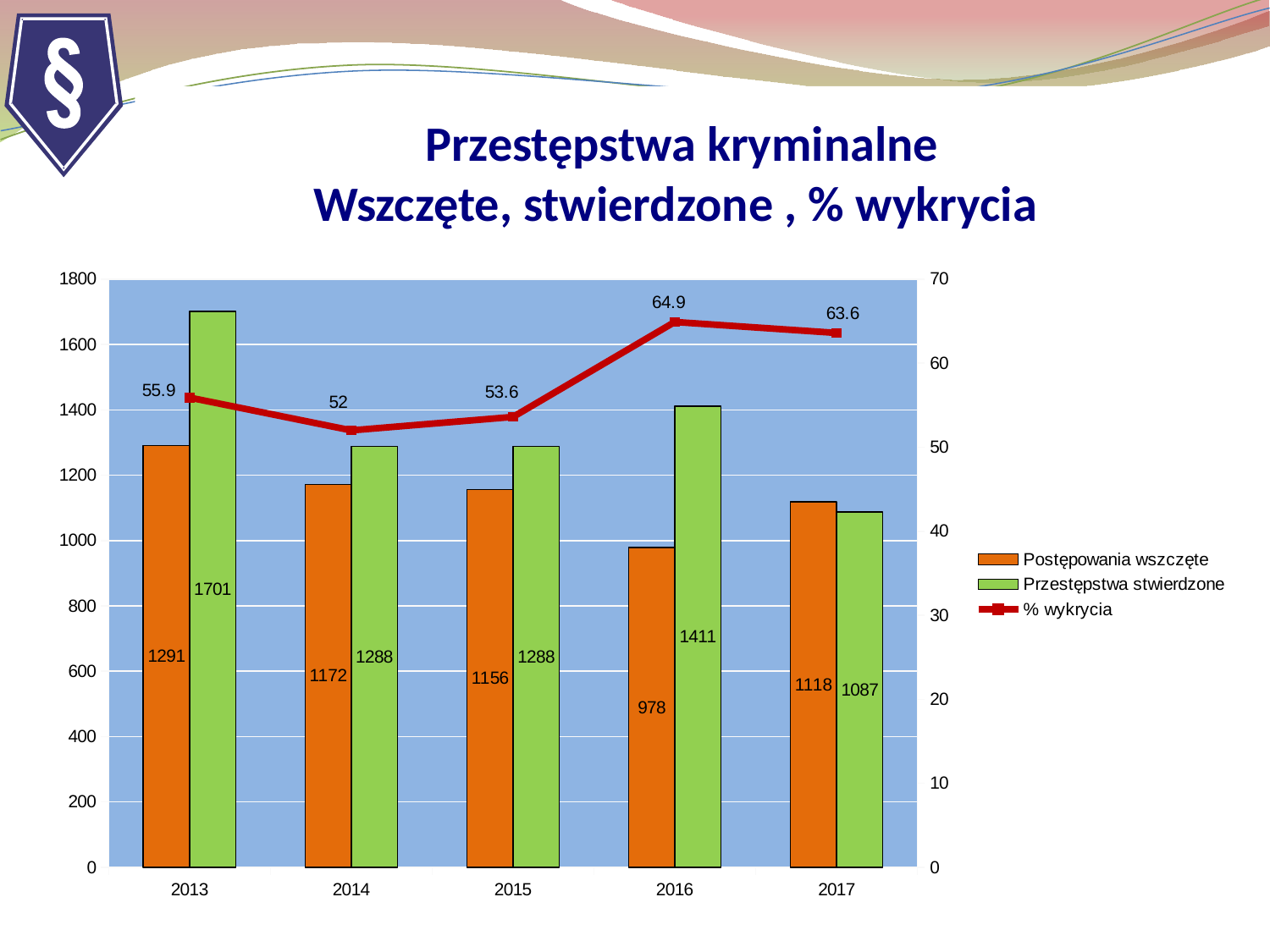
How many years are shown on the x axis? 5 Does the Postępowania wszczęte series rise or fall from 2013 to 2016? Fall Which year has the highest % wykrycia? 2016 What is the value of Przestępstwa stwierdzone for 2016? 1411 What is the difference between Przestępstwa stwierdzone and Postępowania wszczęte in 2013? 410 What is the value of Postępowania wszczęte for 2013? 1291 Which is larger in 2017: Postępowania wszczęte or Przestępstwa stwierdzone? Postępowania wszczęte Which year has the lowest value of Postępowania wszczęte? 2016 Which year has the highest value of Przestępstwa stwierdzone? 2013 What is the % wykrycia value for 2014? 52 What kind of chart is shown on the slide? Combined bar and line chart How many series does the legend list? 3